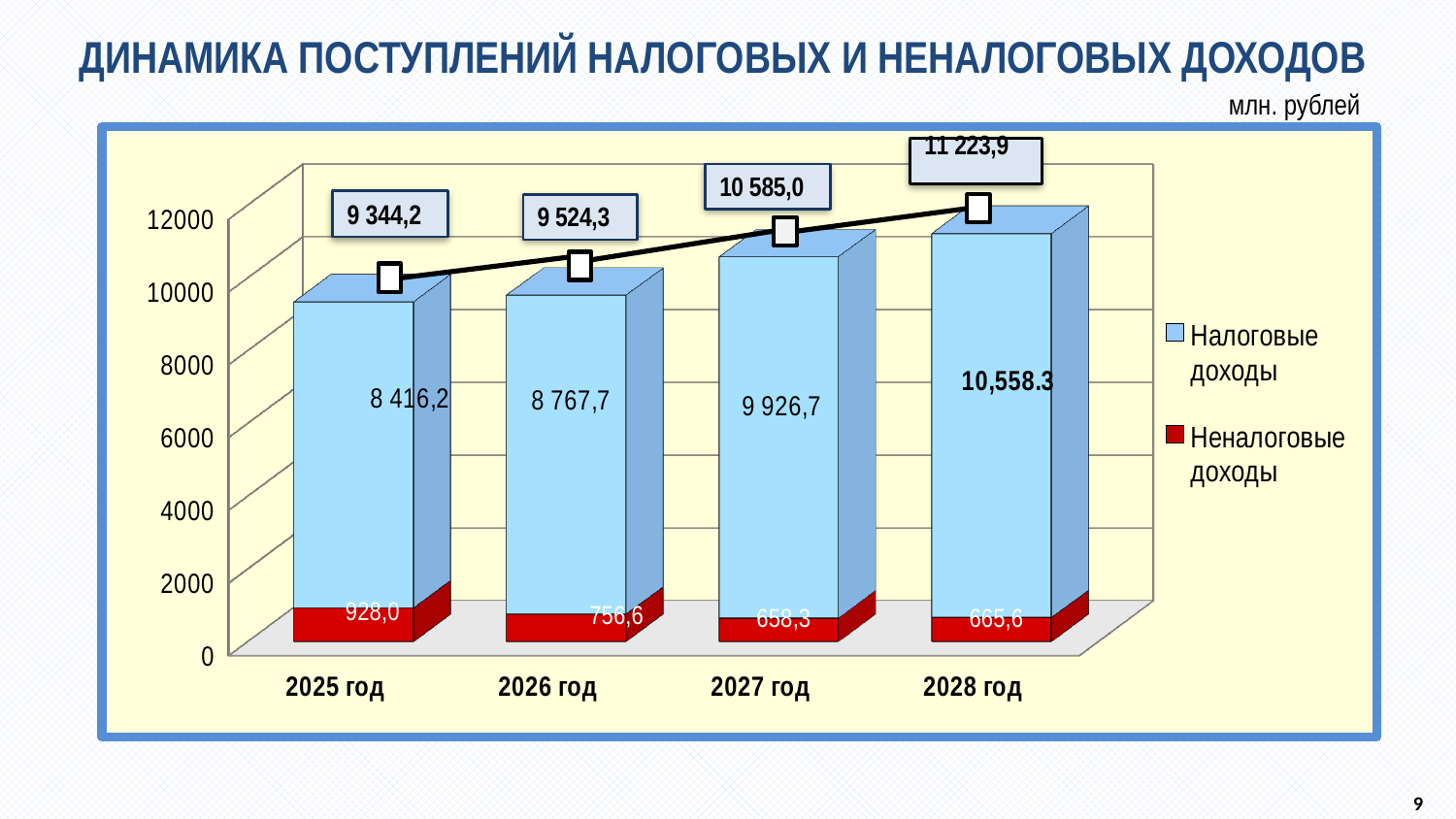
How many years are shown on the x axis? 4 What is the difference between Неналоговые доходы in 2025 год and 2026 год? 171,4 Which year has the highest total shown on the line? 2028 год Which year has the lowest value of Неналоговые доходы? 2027 год What is the value of Налоговые доходы for 2028 год? 10,558.3 Which is larger: Налоговые доходы in 2026 год or in 2027 год? 2027 год What is the value of Налоговые доходы for 2025 год? 8 416,2 What is the difference between the totals for 2028 год and 2025 год? 1 879,7 How many series does the legend list? 2 What total is shown above the bar for 2027 год? 10 585,0 What is the value of Неналоговые доходы for 2026 год? 756,6 Do the totals shown on the line rise or fall from 2025 год to 2028 год? rise